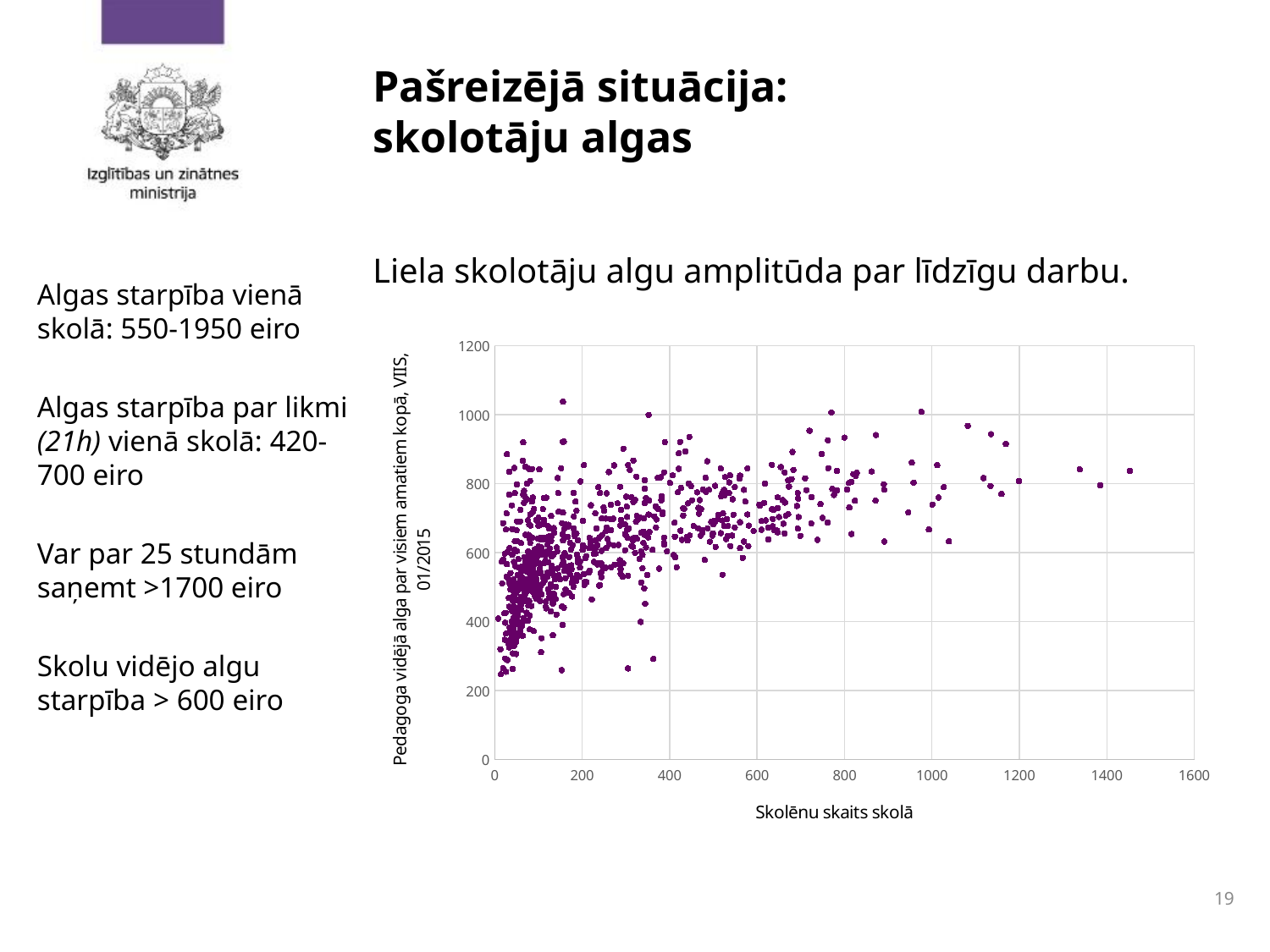
What is the label of the horizontal axis of the chart? Skolēnu skaits skolā Are there any plotted points for schools with more than 1400 students? Yes Is the average salary for the school with the most students (the rightmost point) greater or less than 1000? less Is the average salary for the school with the most students (the rightmost point) greater or less than 600? greater What is the highest tick value shown on the horizontal axis of the chart? 1600 Overall, do the plotted salary values tend to rise or fall as the number of students in the school increases? rise What kind of chart is shown on the slide? scatter plot